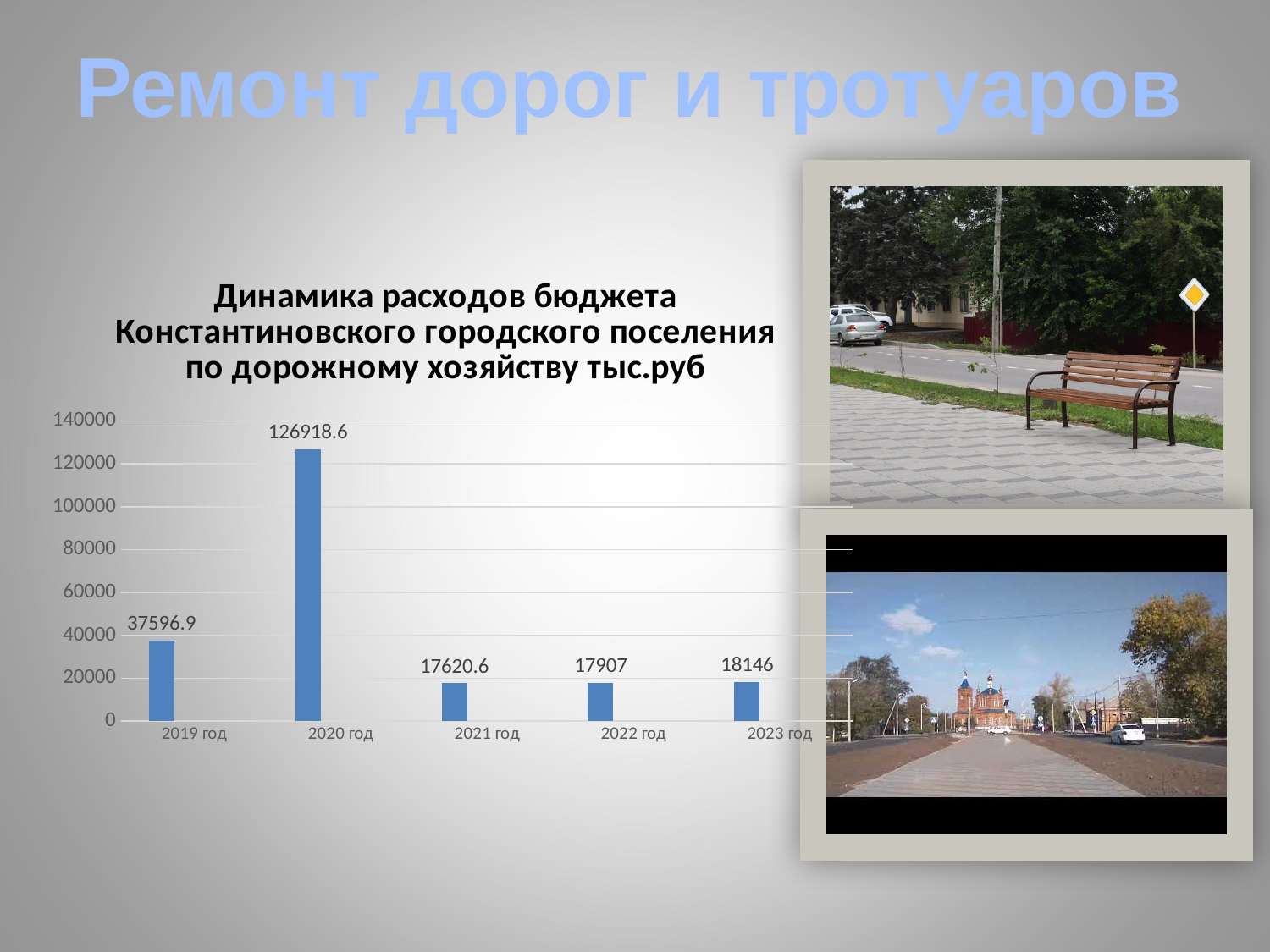
What is the value for 2020 год? 126918.6 Do the values rise or fall from 2021 год to 2023 год? rise Which year has the lowest value? 2021 год What kind of chart is shown on the slide? bar chart What is the value for 2023 год? 18146 Which is larger, the value for 2022 год or 2023 год? 2023 год What is the value for 2019 год? 37596.9 Is the value for 2019 год greater or less than 40000? less How many years are shown on the x axis? 5 What is the difference between the values for 2020 год and 2019 год? 89321.7 Which year has the highest value? 2020 год What is the difference between the values for 2023 год and 2022 год? 239